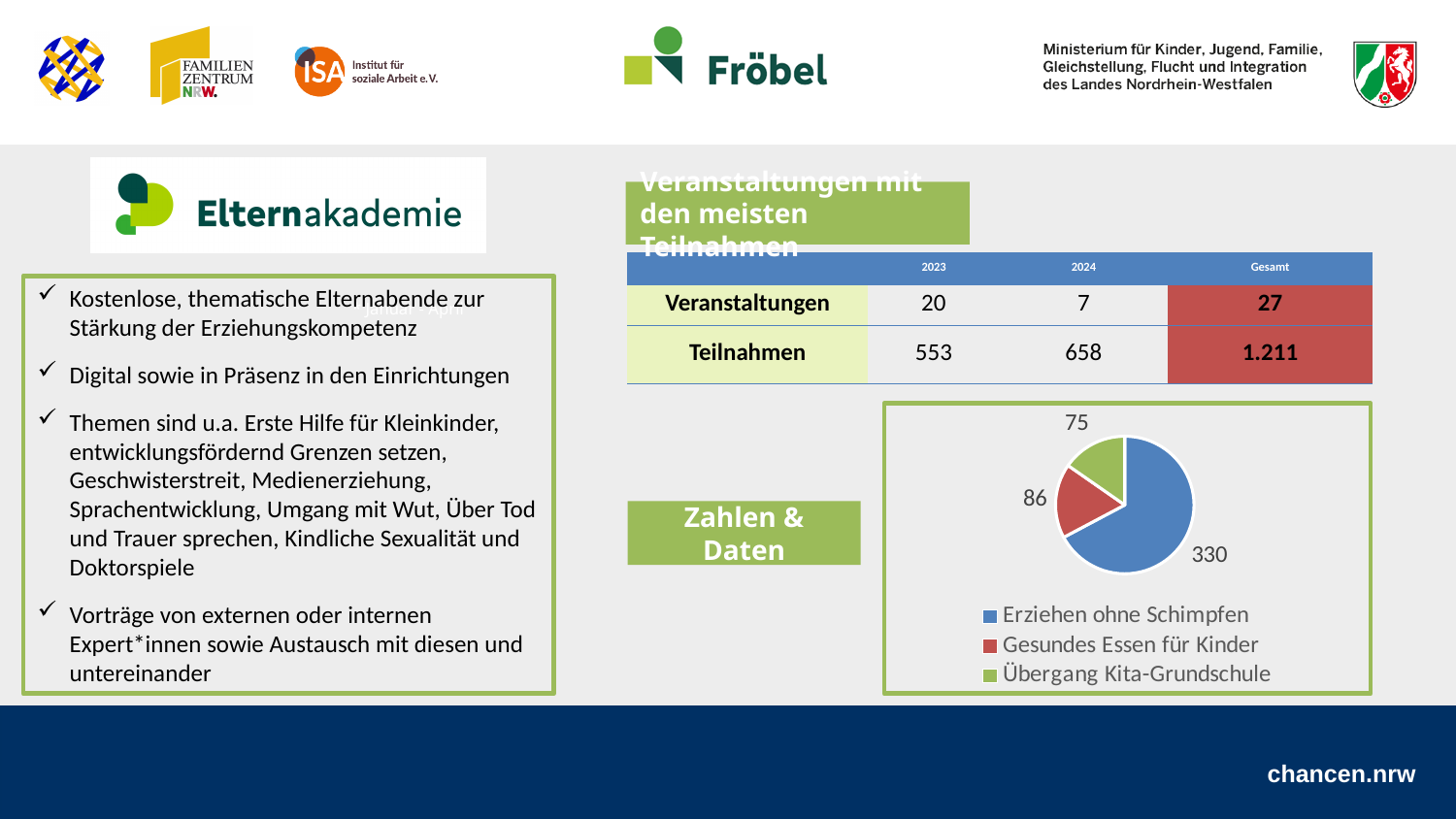
In the pie chart, which is larger: Gesundes Essen für Kinder or Übergang Kita-Grundschule? Gesundes Essen für Kinder In the pie chart, what is the value for Erziehen ohne Schimpfen? 330 In the pie chart, what is the difference between the values for Erziehen ohne Schimpfen and Gesundes Essen für Kinder? 244 What colour is the slice for Übergang Kita-Grundschule in the pie chart? green In the pie chart, what is the value for Gesundes Essen für Kinder? 86 Which category has the smallest slice in the pie chart? Übergang Kita-Grundschule Which category has the largest slice in the pie chart? Erziehen ohne Schimpfen In the pie chart, what is the value for Übergang Kita-Grundschule? 75 How many categories does the pie chart show? 3 What kind of chart is shown on the right side of the slide under the table? pie chart In the pie chart, what is the difference between the values for Gesundes Essen für Kinder and Übergang Kita-Grundschule? 11 What colour is the slice for Erziehen ohne Schimpfen in the pie chart? blue